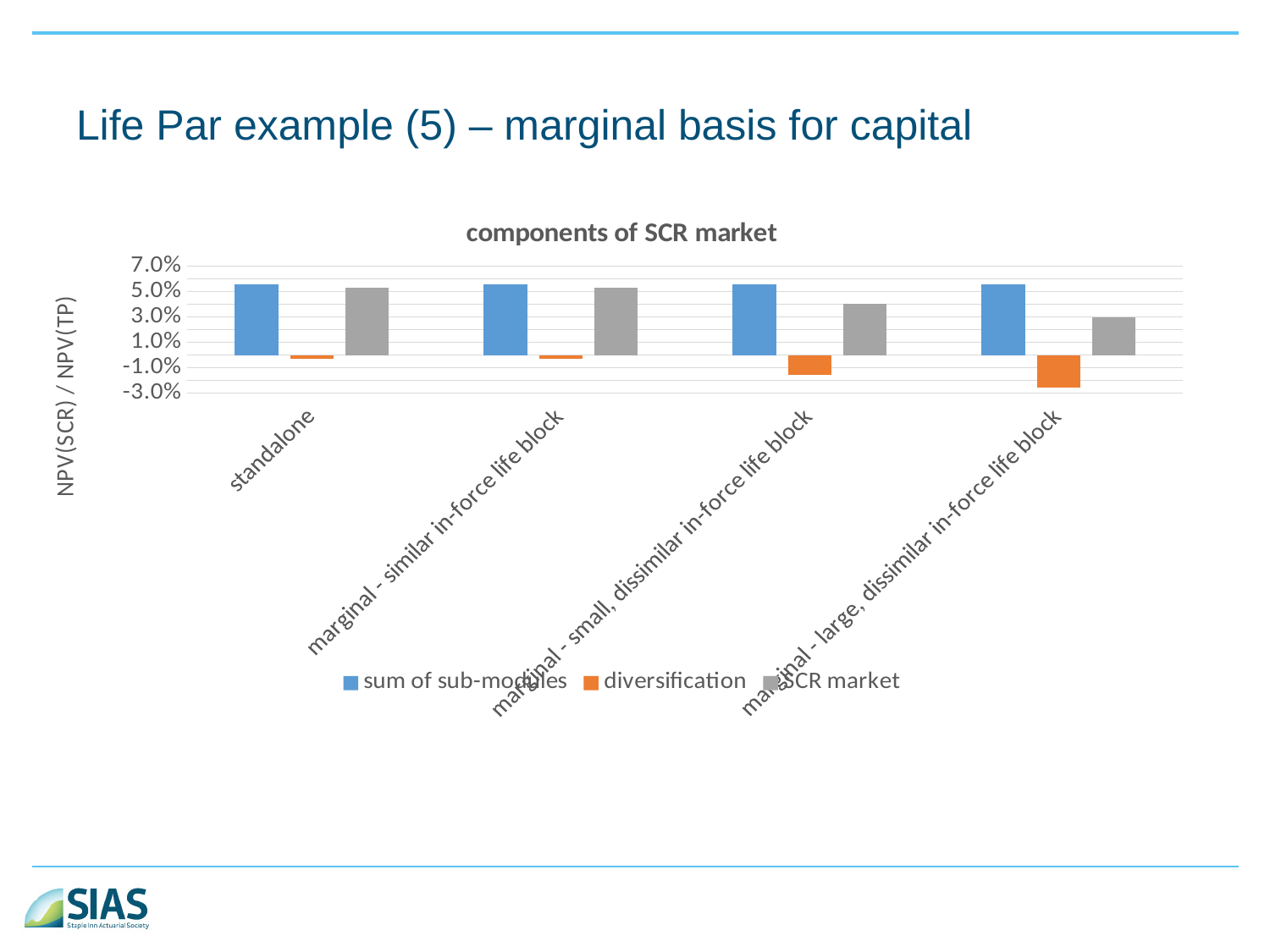
Which category has the lowest (most negative) diversification value? marginal - large, dissimilar in-force life block Which category has the lowest SCR market value? marginal - large, dissimilar in-force life block What is the title of the chart? components of SCR market How many series does the legend list? 3 Which is larger: the SCR market value for 'standalone' or for 'marginal - small, dissimilar in-force life block'? standalone What kind of chart is shown on the slide? bar chart Is the value of SCR market for 'standalone' greater or less than 3.0%? greater How many categories are shown on the x axis of the chart? 4 Is the value of sum of sub-modules for 'marginal - similar in-force life block' greater or less than 5.0%? greater Is the value of diversification for 'marginal - large, dissimilar in-force life block' greater or less than -1.0%? less Do the SCR market values rise or fall moving from left to right across the categories? fall What is the label on the vertical axis of the chart? NPV(SCR) / NPV(TP)